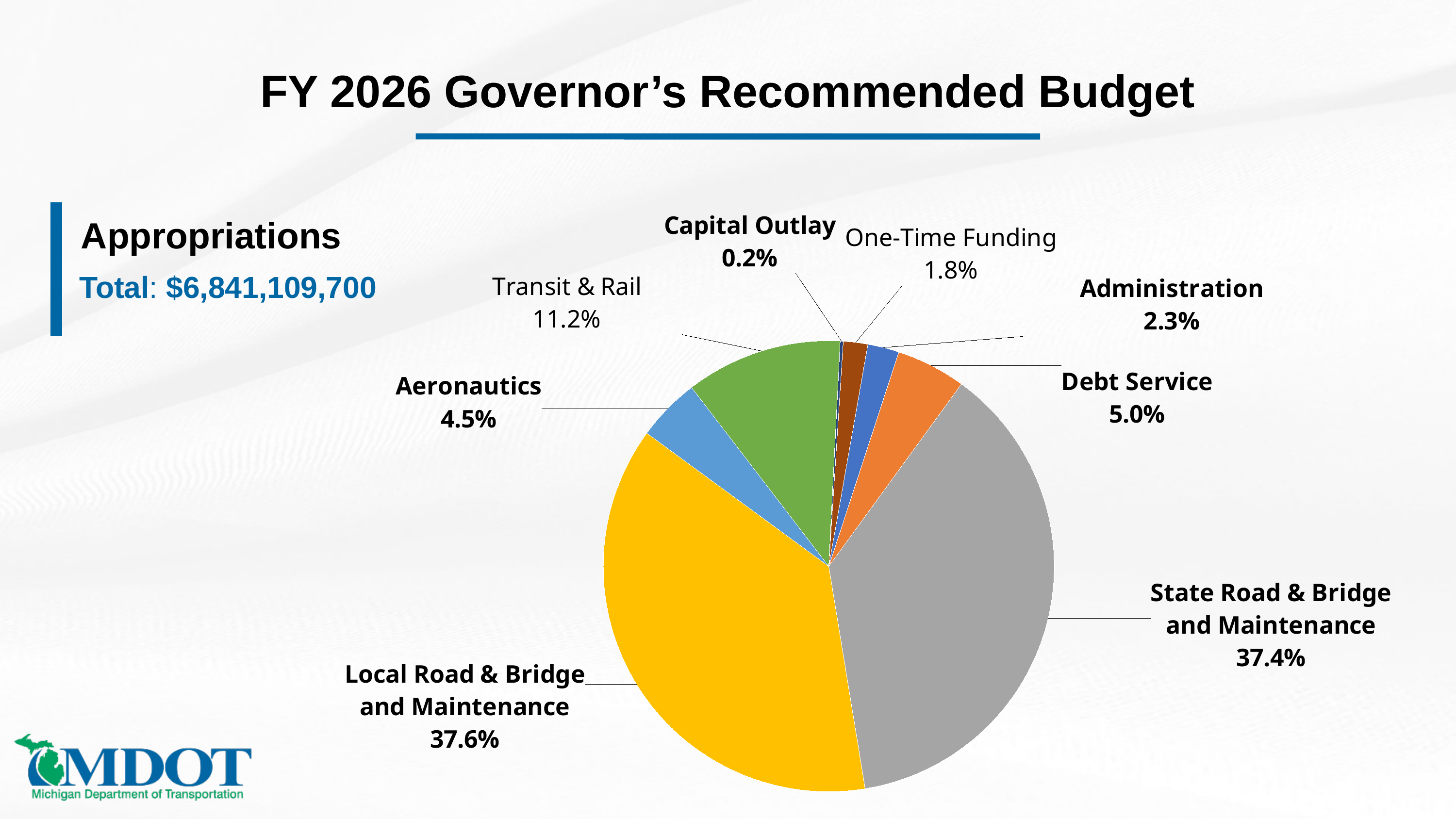
What is the value shown for One-Time Funding? 1.8% What is the difference in percentage points between Local Road & Bridge and Maintenance and State Road & Bridge and Maintenance? 0.2 percentage points What share of the pie does Transit & Rail represent? 11.2% How many slices does the pie chart have? 8 Which is larger, Transit & Rail or Debt Service? Transit & Rail What total appropriations amount is stated on the slide? $6,841,109,700 What percentage is shown for Aeronautics? 4.5% Which category has the smallest slice of the pie? Capital Outlay What is the difference in percentage points between Transit & Rail and Aeronautics? 6.7 percentage points What kind of chart is shown on the slide? Pie chart What percentage is shown for State Road & Bridge and Maintenance? 37.4% What is the value shown for Debt Service? 5.0%